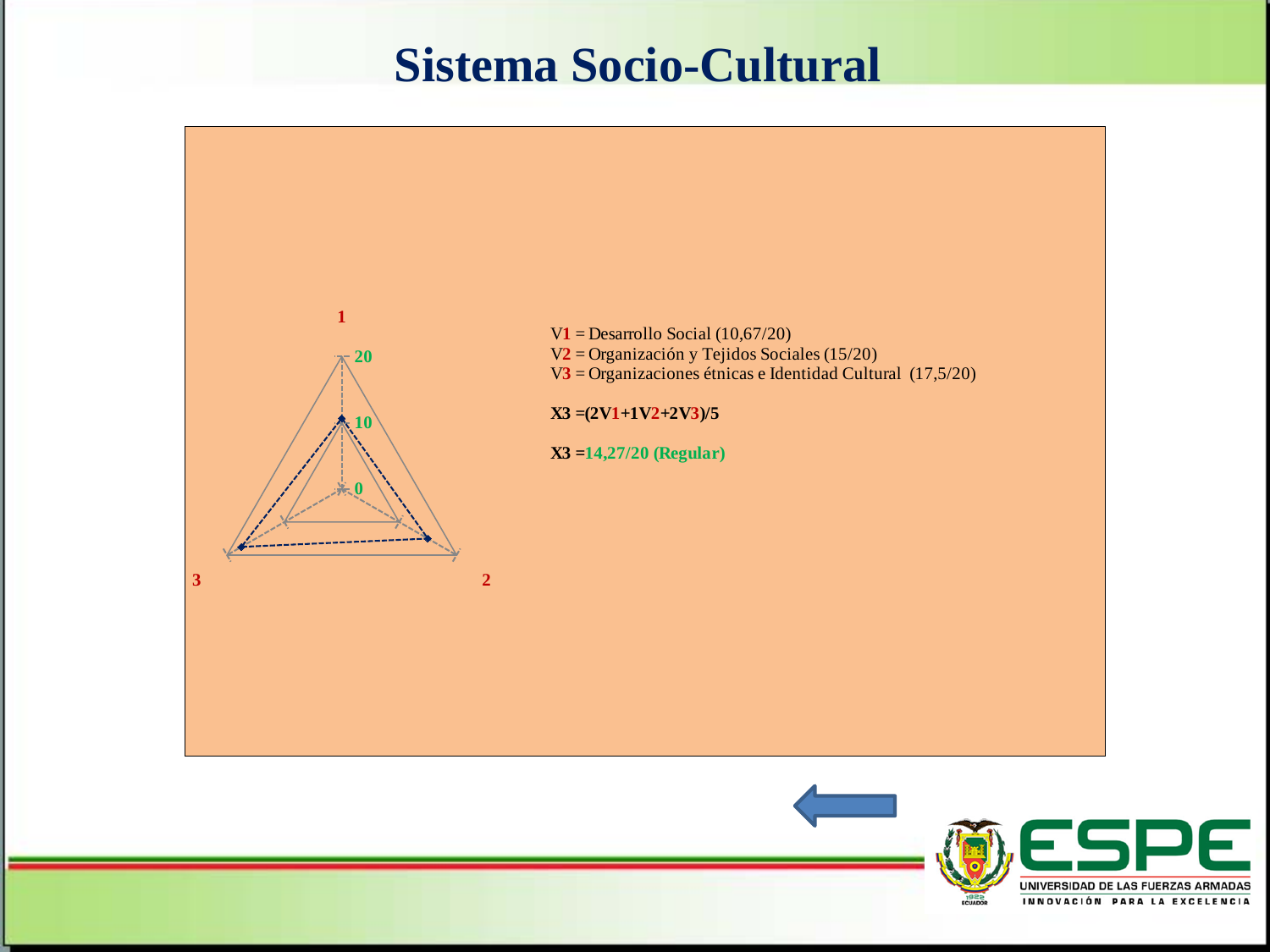
What kind of chart is shown on the slide? radar chart Is the value on axis 2 of the radar chart greater or less than 10? greater Is the value on axis 3 of the radar chart greater or less than 20? less What is the final X3 result stated on the slide? 14,27/20 (Regular) What is the maximum value shown on the radar chart's scale? 20 Which axis of the radar chart has the highest value? 3 According to the slide, what is the value of V1 (Desarrollo Social)? 10,67/20 Which axis of the radar chart has the lowest value? 1 According to the slide, what is the value of V2 (Organización y Tejidos Sociales)? 15/20 What is the difference between the values of V3 and V2? 2,5 How many axes (categories) does the radar chart have? 3 According to the slide, what is the value of V3 (Organizaciones étnicas e Identidad Cultural)? 17,5/20